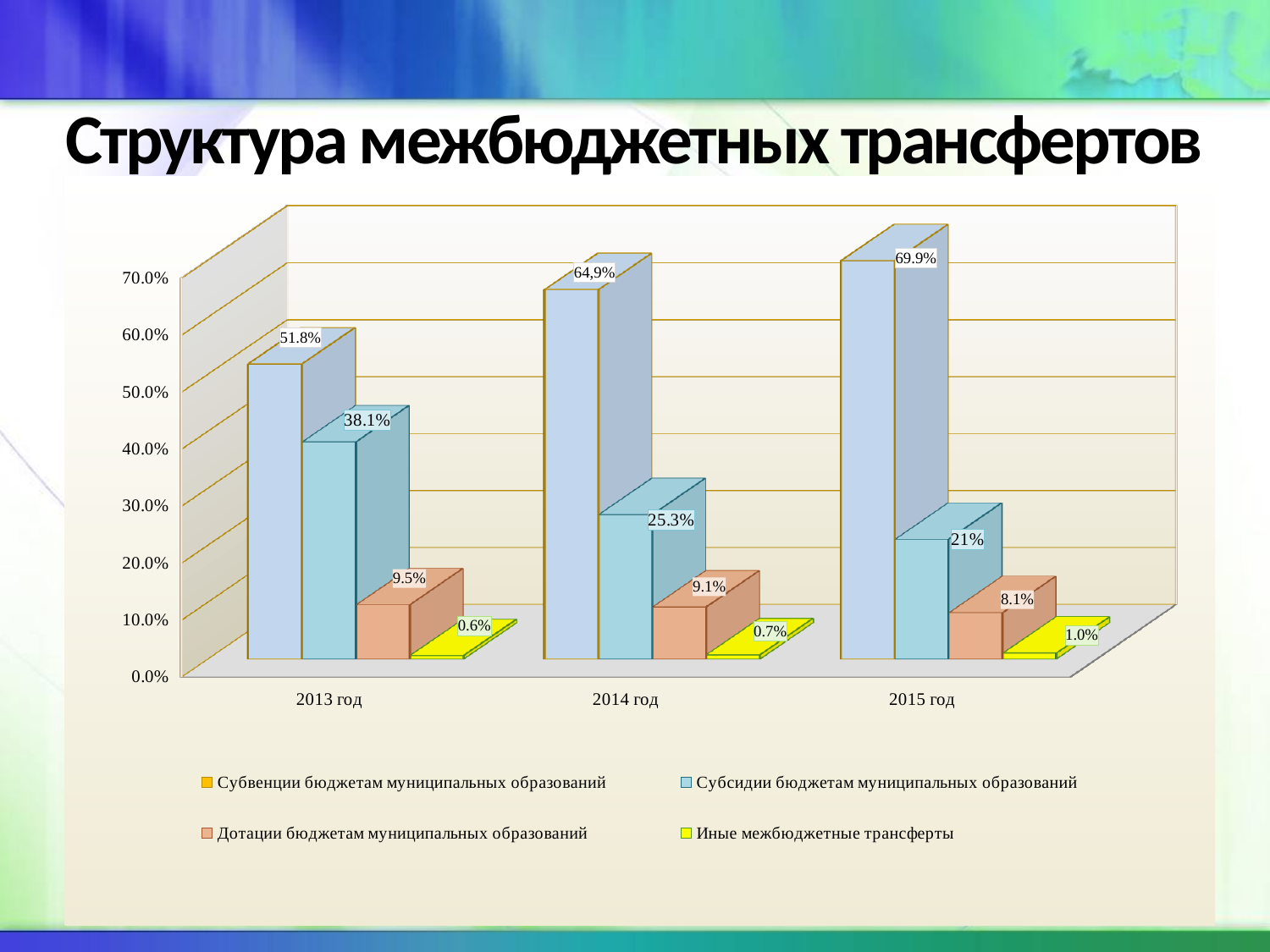
What is the value for Субвенции бюджетам муниципальных образований in 2015 год? 69.9% How many year categories are shown on the x axis? 3 What is the value for Субсидии бюджетам муниципальных образований in 2013 год? 38.1% What is the value for Иные межбюджетные трансферты in 2015 год? 1.0% In which year is the value for Субсидии бюджетам муниципальных образований lowest? 2015 год What is the chart's title? Структура межбюджетных трансфертов In which year is the value for Субвенции бюджетам муниципальных образований highest? 2015 год What type of chart is shown on the slide? bar chart What is the difference between the Субсидии values for 2013 год and 2015 год? 17.1% How many series does the legend list? 4 What is the value for Дотации бюджетам муниципальных образований in 2014 год? 9.1% Does the value for Субвенции бюджетам муниципальных образований rise or fall from 2013 год to 2015 год? rise